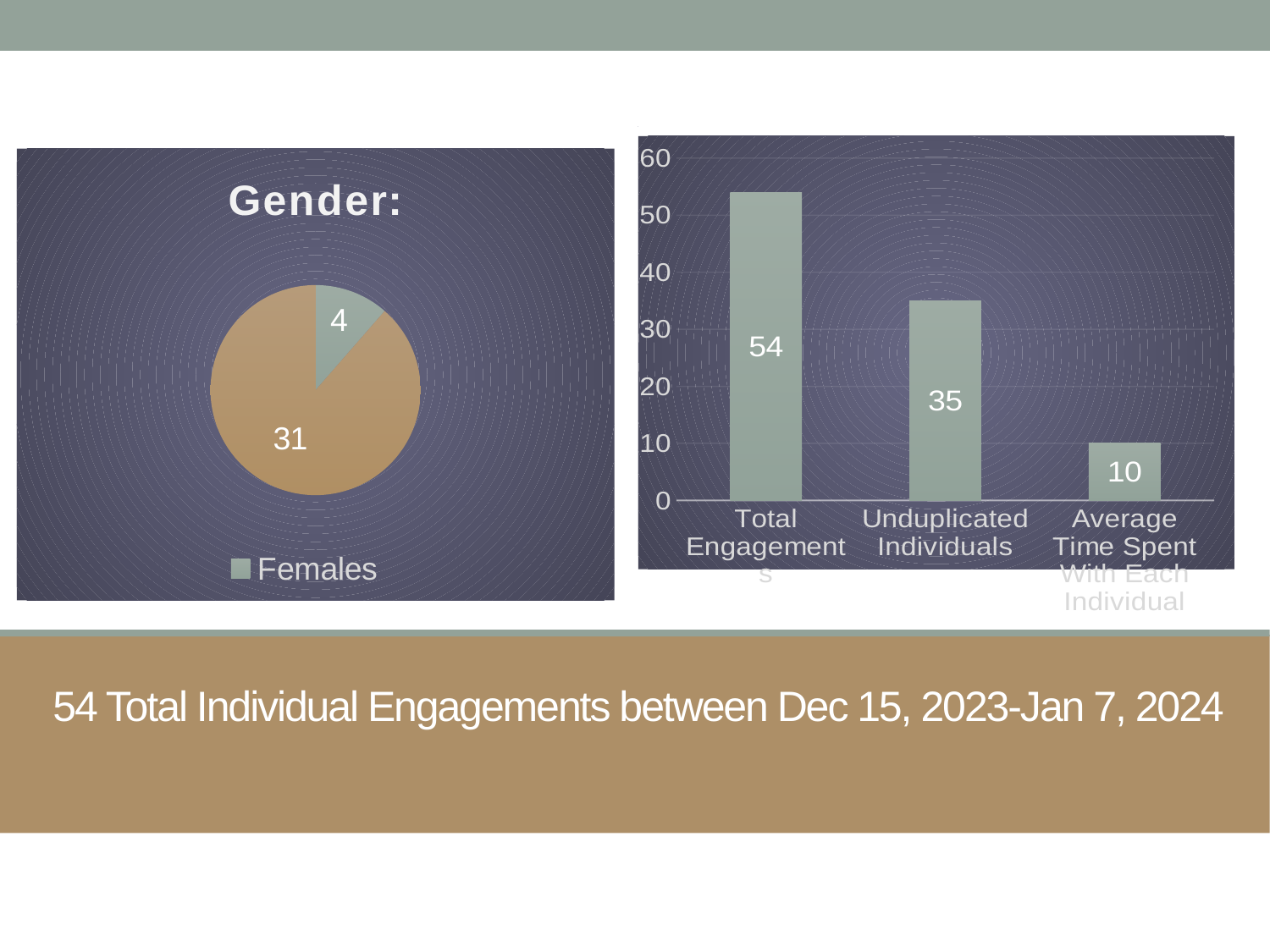
What kind of chart is the Gender chart on the left? Pie chart In the bar chart on the right, what is the difference between Total Engagements and Unduplicated Individuals? 19 In the bar chart on the right, how many categories are shown? 3 In the Gender pie chart, what is the value for Females? 4 In the bar chart on the right, do the values rise or fall from left to right? Fall In the bar chart on the right, which is larger: Unduplicated Individuals or Average Time Spent With Each Individual? Unduplicated Individuals In the bar chart on the right, what is the value for Average Time Spent With Each Individual? 10 In the bar chart on the right, which category has the lowest value? Average Time Spent With Each Individual In the bar chart on the right, what is the value for Unduplicated Individuals? 35 What kind of chart is the chart on the right? Bar chart In the bar chart on the right, what is the value for Total Engagements? 54 In the bar chart on the right, which category has the highest value? Total Engagements